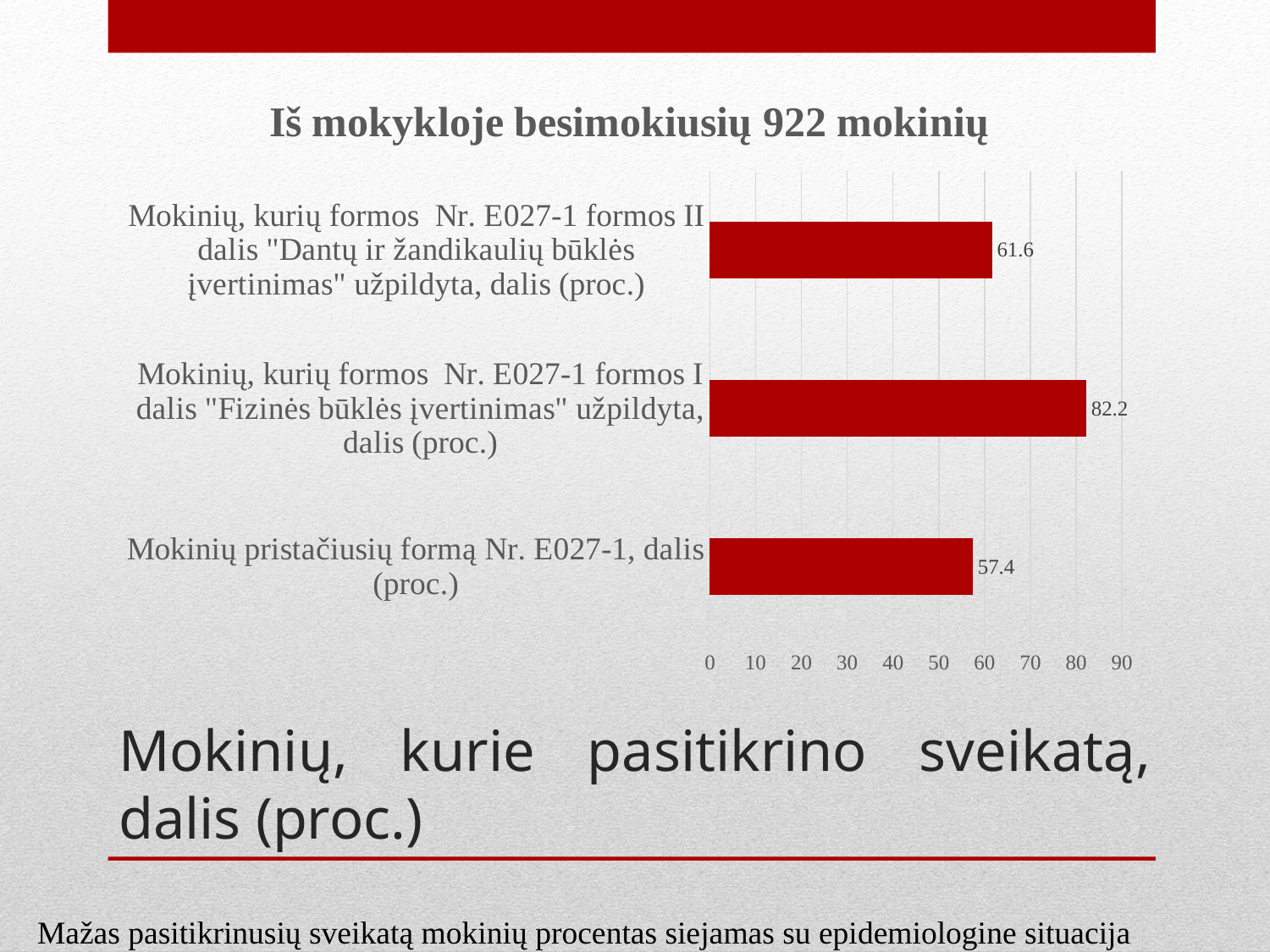
What is the difference between the value for form I part "Fizinės būklės įvertinimas" and the value for form II part "Dantų ir žandikaulių būklės įvertinimas"? 20.6 What is the title of the chart? Iš mokykloje besimokiusių 922 mokinių How many categories are shown in the chart? 3 What is the difference between the value for form II part "Dantų ir žandikaulių būklės įvertinimas" and the value for "Mokinių pristačiusių formą Nr. E027-1"? 4.2 What is the value for the category about form I part "Fizinės būklės įvertinimas"? 82.2 Is the value for form I part "Fizinės būklės įvertinimas" greater or less than 80? greater What kind of chart is shown on the slide? Bar chart What is the value for "Mokinių pristačiusių formą Nr. E027-1, dalis (proc.)"? 57.4 Which is larger: the value for form II part "Dantų ir žandikaulių būklės įvertinimas" or the value for "Mokinių pristačiusių formą Nr. E027-1"? Form II part "Dantų ir žandikaulių būklės įvertinimas" (61.6) Which category has the lowest value? Mokinių pristačiusių formą Nr. E027-1, dalis (proc.) What is the value for the category about form II part "Dantų ir žandikaulių būklės įvertinimas"? 61.6 Which category has the highest value? Mokinių, kurių formos Nr. E027-1 formos I dalis "Fizinės būklės įvertinimas" užpildyta, dalis (proc.)